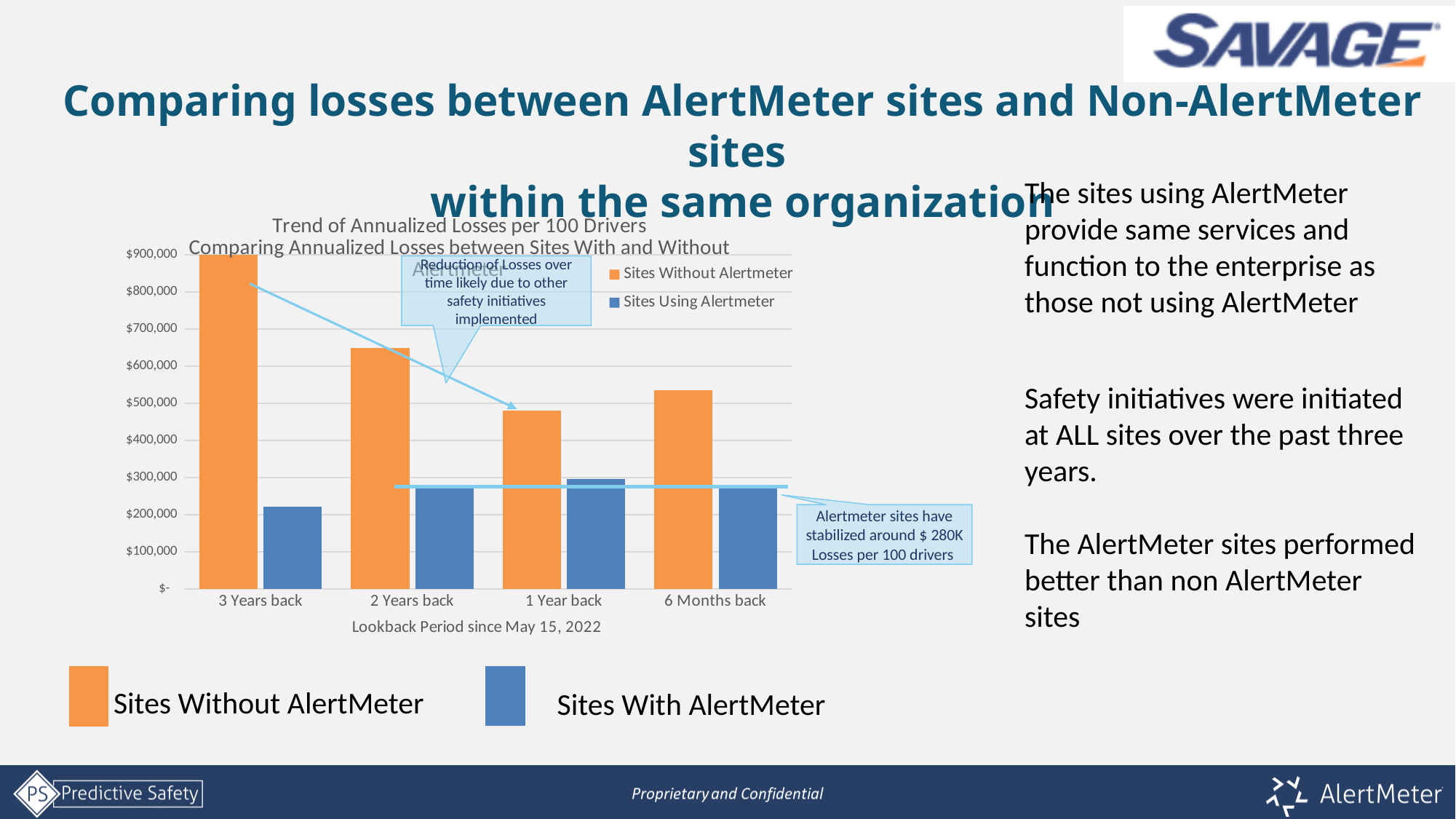
What is the title of the x axis of the chart? Lookback Period since May 15, 2022 At 3 Years back, which series has the larger value: Sites Without Alertmeter or Sites Using Alertmeter? Sites Without Alertmeter What kind of chart is shown on the slide? Bar chart How many series does the chart legend list? 2 Is the value for Sites Using Alertmeter at 2 Years back greater or less than $300,000? less How many lookback periods (categories) are shown on the x axis? 4 In which lookback period is the value for Sites Without Alertmeter lowest? 1 Year back Is the value for Sites Without Alertmeter at 1 Year back greater or less than $500,000? less Does the value for Sites Without Alertmeter rise or fall from 3 Years back to 1 Year back? Fall In which lookback period is the value for Sites Without Alertmeter highest? 3 Years back In which lookback period is the value for Sites Using Alertmeter lowest? 3 Years back Is the value for Sites Without Alertmeter at 3 Years back greater or less than $800,000? greater